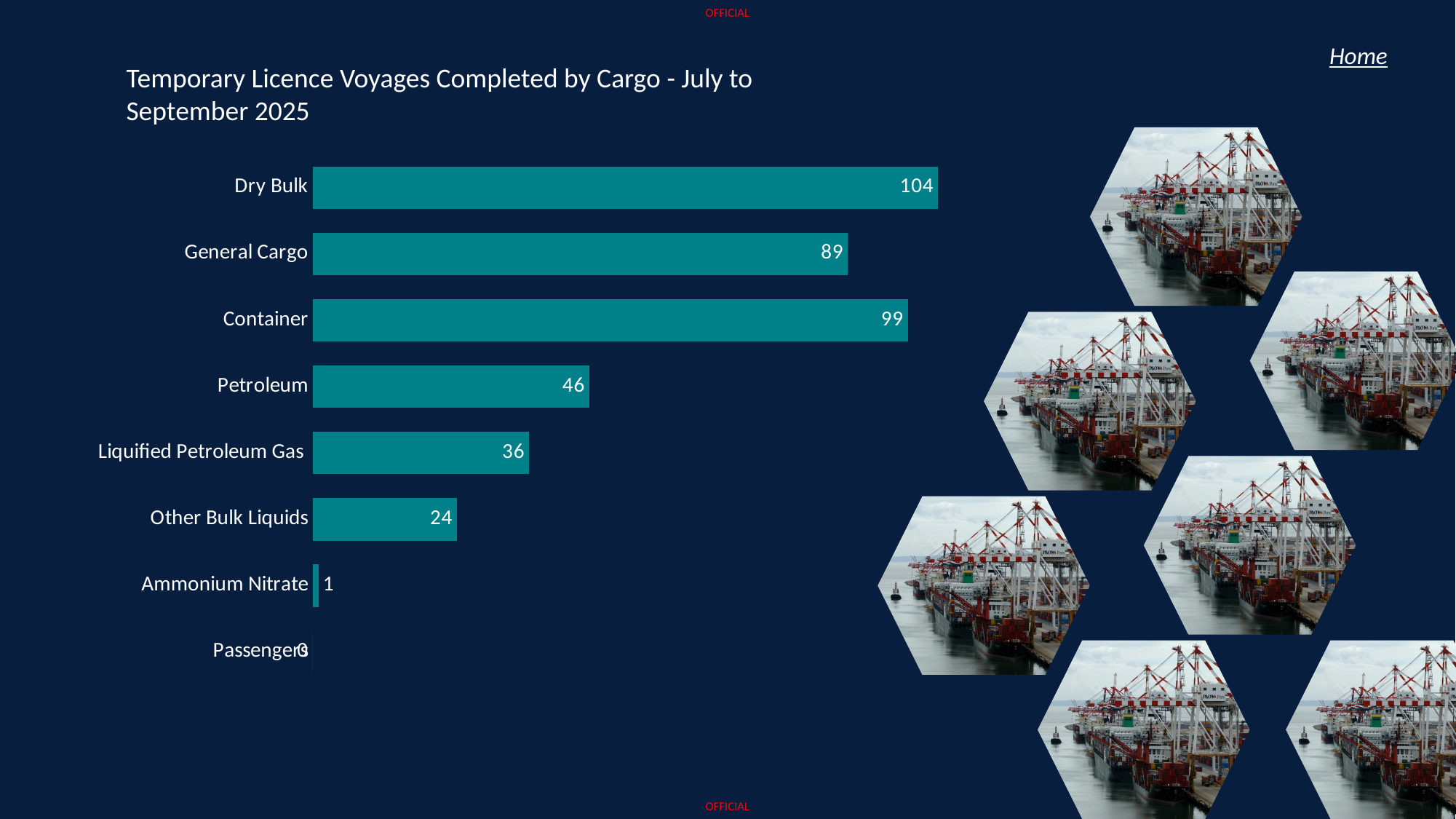
Which is larger, the value for Container or the value for General Cargo? Container What kind of chart is shown on the slide? Bar chart Which cargo category has the highest number of voyages? Dry Bulk What is the value for Dry Bulk? 104 Which cargo category has the lowest number of voyages? Passengers What is the difference between the values for Petroleum and Other Bulk Liquids? 22 How many cargo categories are shown in the chart? 8 What is the title of the chart? Temporary Licence Voyages Completed by Cargo - July to September 2025 What is the value for Liquified Petroleum Gas? 36 What is the difference between the values for Dry Bulk and General Cargo? 15 What is the value for Ammonium Nitrate? 1 What is the value for Container? 99